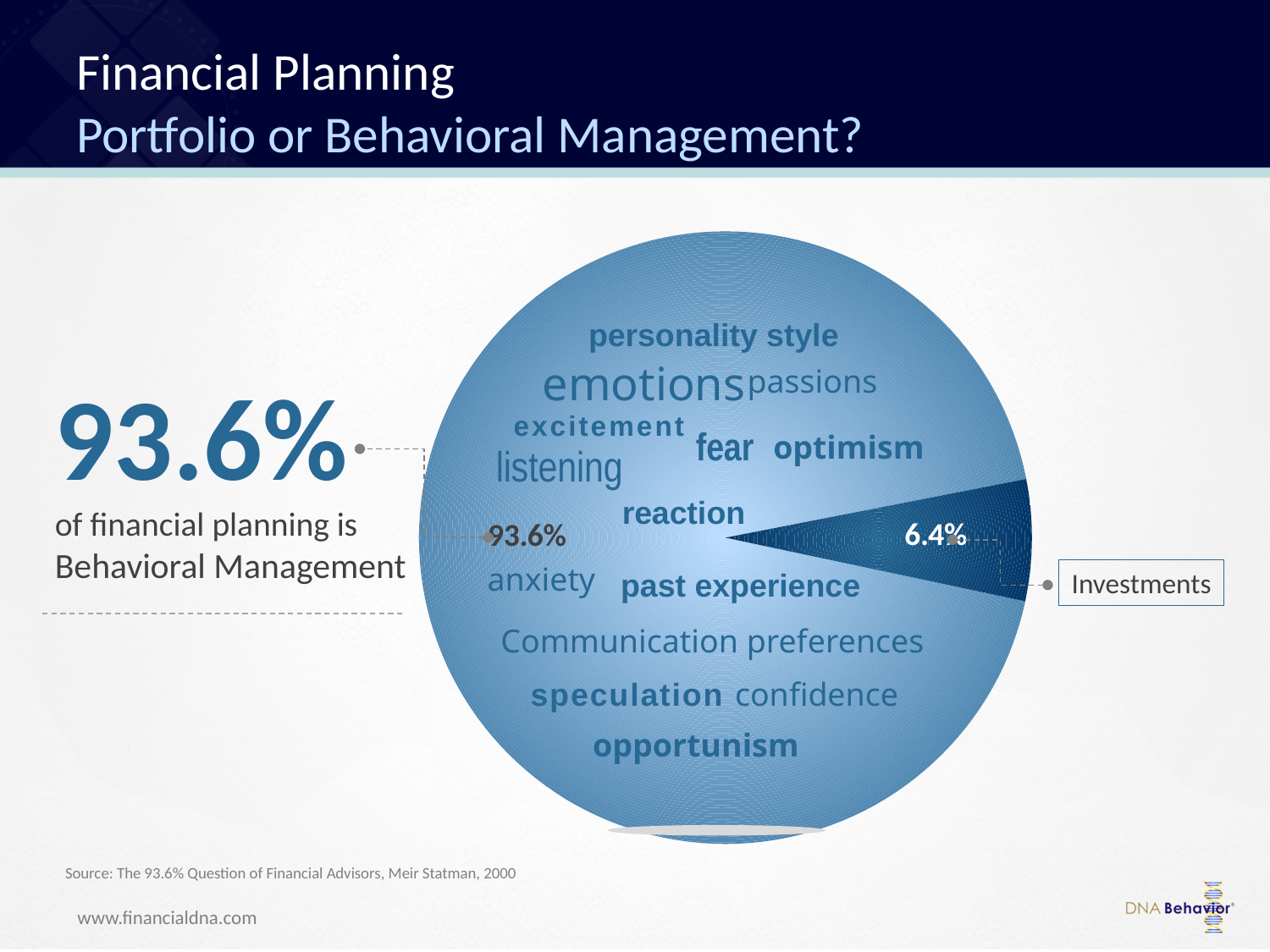
What label is shown in the box connected to the small dark slice of the pie? Investments Is the Investments slice greater or less than 10%? less Which is larger, the Behavioral Management slice or the Investments slice? Behavioral Management Which slice of the pie chart is the largest? Behavioral Management (93.6%) How many slices does the pie chart have? 2 Which slice of the pie chart is the smallest? Investments (6.4%) What share of the pie is attributed to Behavioral Management? 93.6% What share of the pie is labelled Investments? 6.4% What kind of chart is shown on the slide? pie chart What is the difference in percentage points between the 93.6% slice and the 6.4% slice? 87.2 What do the two slices of the pie chart add up to? 100% What is the source cited for the pie chart data? The 93.6% Question of Financial Advisors, Meir Statman, 2000